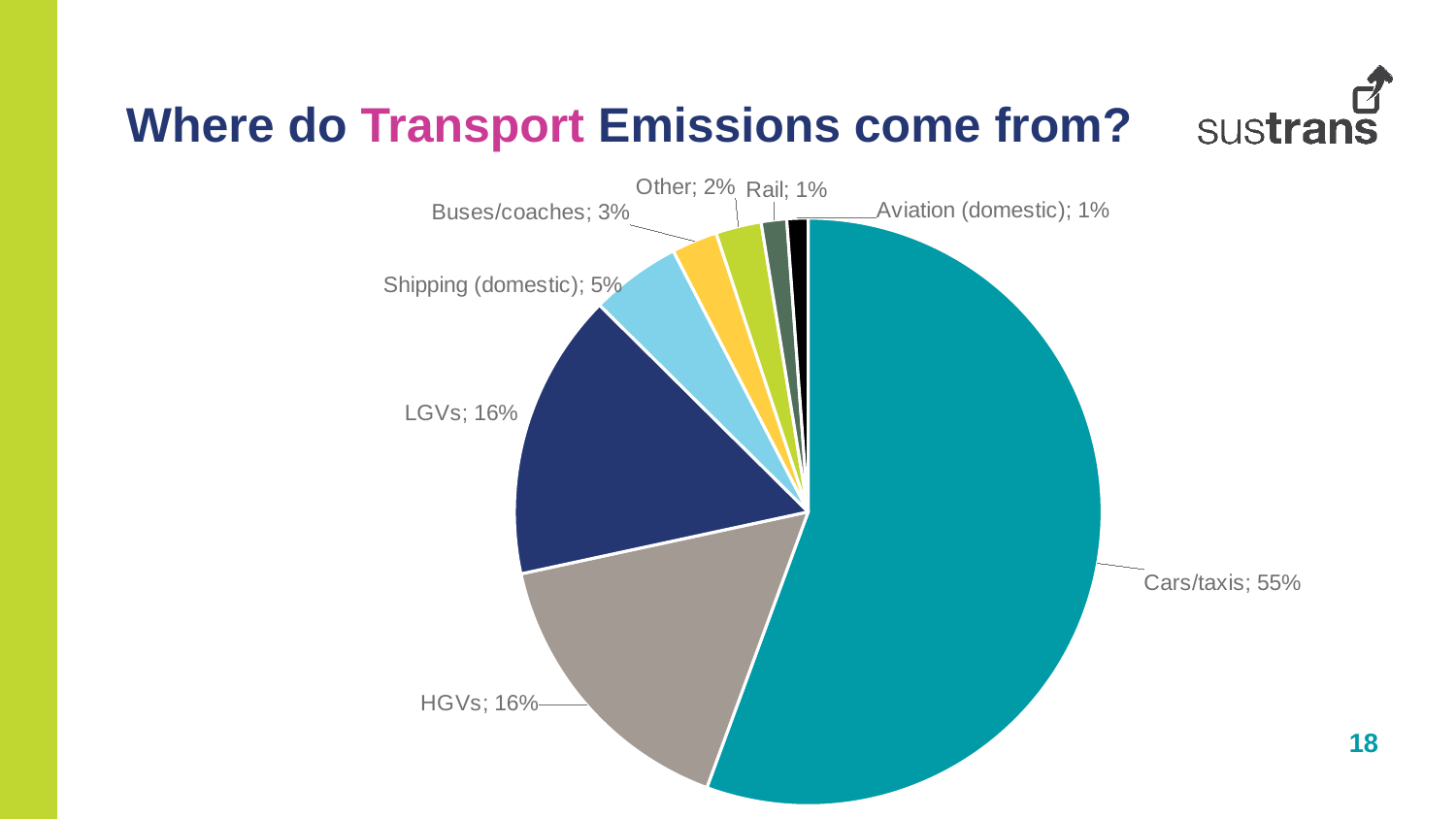
What is the combined share of LGVs and HGVs? 32% What is the difference between the Cars/taxis share and the HGVs share? 39% What kind of chart is shown on the slide? Pie chart What is the value shown for LGVs? 16% How many categories are shown in the pie chart? 8 What is the value shown for Buses/coaches? 3% Which category has the largest slice of the pie? Cars/taxis What share of transport emissions comes from Cars/taxis? 55% What is the title of the slide containing the chart? Where do Transport Emissions come from? What is the value shown for Shipping (domestic)? 5% Which is larger, the share for Shipping (domestic) or the share for Buses/coaches? Shipping (domestic) What is the value shown for Other? 2%